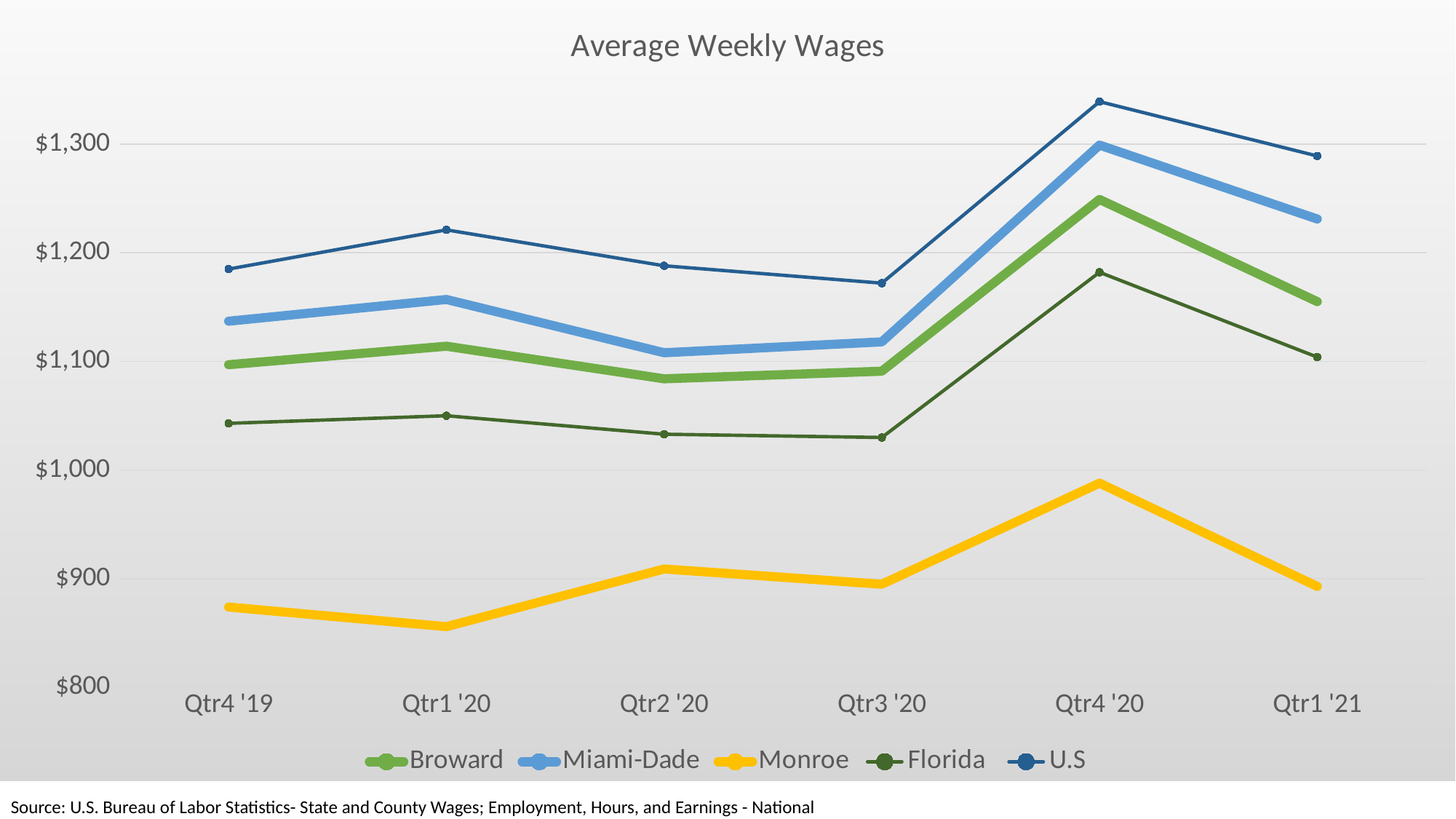
What is the title of the chart? Average Weekly Wages How many quarters are plotted along the x axis? 6 Which series has the highest value in Qtr4 '20? U.S Is the value for Florida in Qtr3 '20 greater or less than $1,000? greater What kind of chart is shown on the slide? line chart In Qtr1 '21, which is larger: Broward or Florida? Broward How many series does the legend list? 5 Is the value for Florida in Qtr4 '20 greater or less than $1,200? less Is the value for Monroe in Qtr1 '20 greater or less than $900? less Which series has the lowest average weekly wages in every quarter shown? Monroe Does the Monroe line rise or fall from Qtr4 '20 to Qtr1 '21? fall